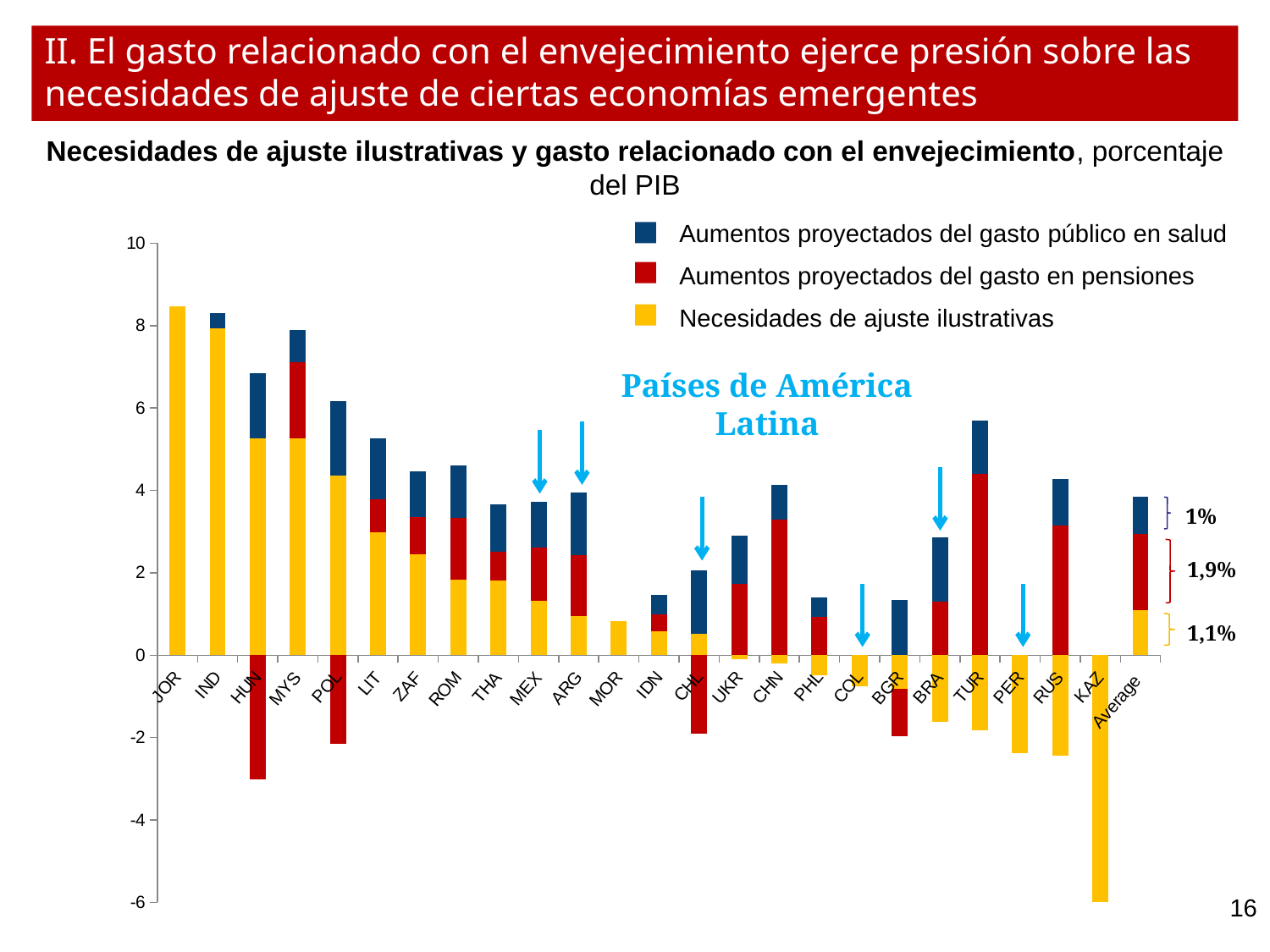
Which has the larger 'Aumentos proyectados del gasto en pensiones' value, TUR or CHN? TUR Which country has the highest value for 'Necesidades de ajuste ilustrativas'? JOR Is the value of 'Necesidades de ajuste ilustrativas' for KAZ greater or less than -4? less What kind of chart is shown on the slide? Stacked bar chart What is the labelled value of 'Aumentos proyectados del gasto público en salud' for Average? 1% How many series does the legend list? 3 Is the value of 'Necesidades de ajuste ilustrativas' for JOR greater or less than 8? greater What is the labelled value of 'Aumentos proyectados del gasto en pensiones' for Average? 1,9% What is the labelled value of 'Necesidades de ajuste ilustrativas' for Average? 1,1% Which series is shown in yellow in the legend? Necesidades de ajuste ilustrativas How many categories are shown along the x axis? 25 Which country has the lowest value for 'Necesidades de ajuste ilustrativas'? KAZ